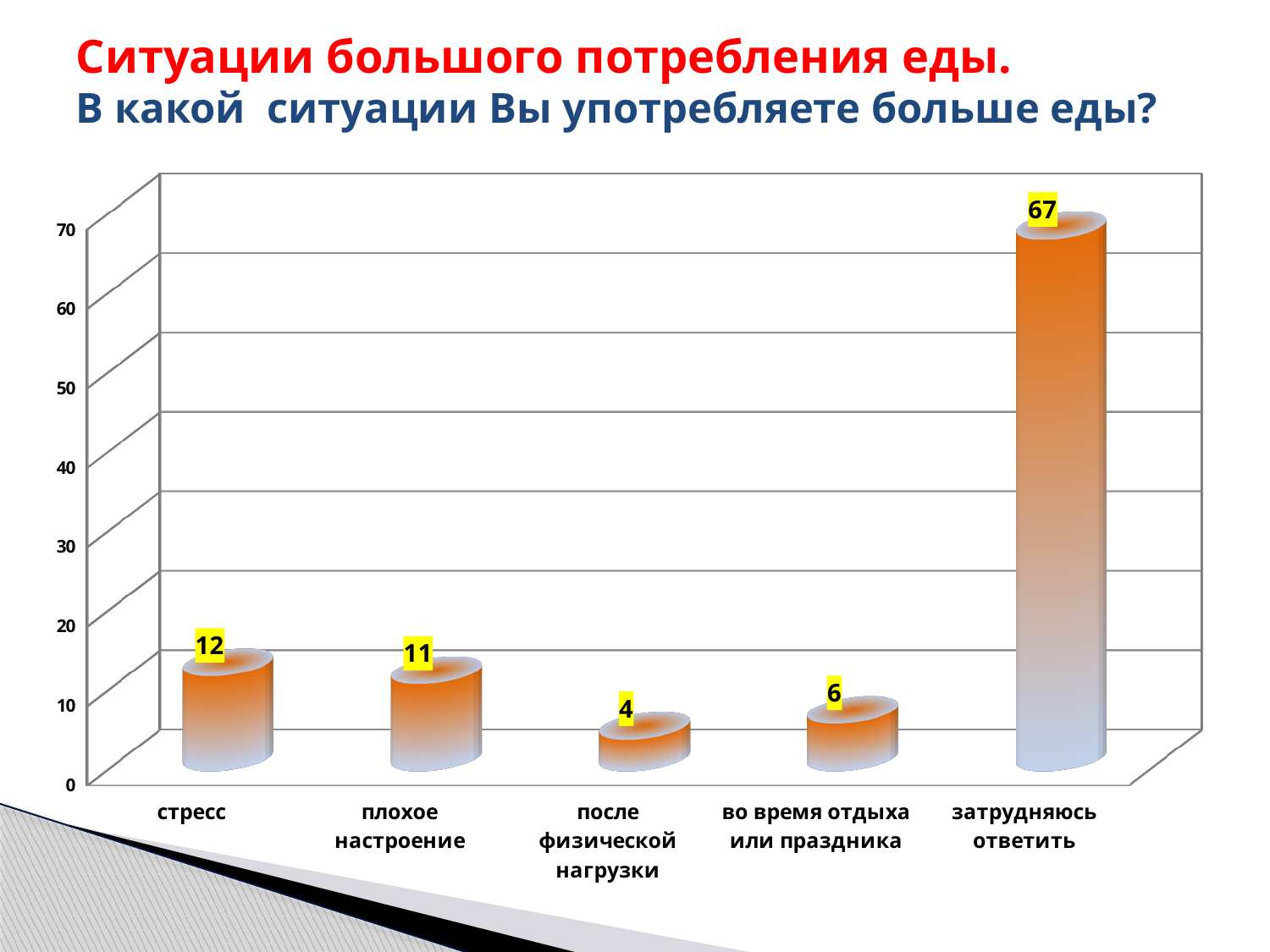
What is the value for стресс? 12 Which category has the lowest value? после физической нагрузки What is the value for во время отдыха или праздника? 6 What is the value for затрудняюсь ответить? 67 Which category has the highest value? затрудняюсь ответить What is the value for после физической нагрузки? 4 What kind of chart is shown on the slide? bar chart Is the value for затрудняюсь ответить greater or less than 60? greater Which is larger, the value for стресс or the value for во время отдыха или праздника? стресс How many categories are shown on the chart? 5 What is the value for плохое настроение? 11 What is the difference between the values for затрудняюсь ответить and стресс? 55